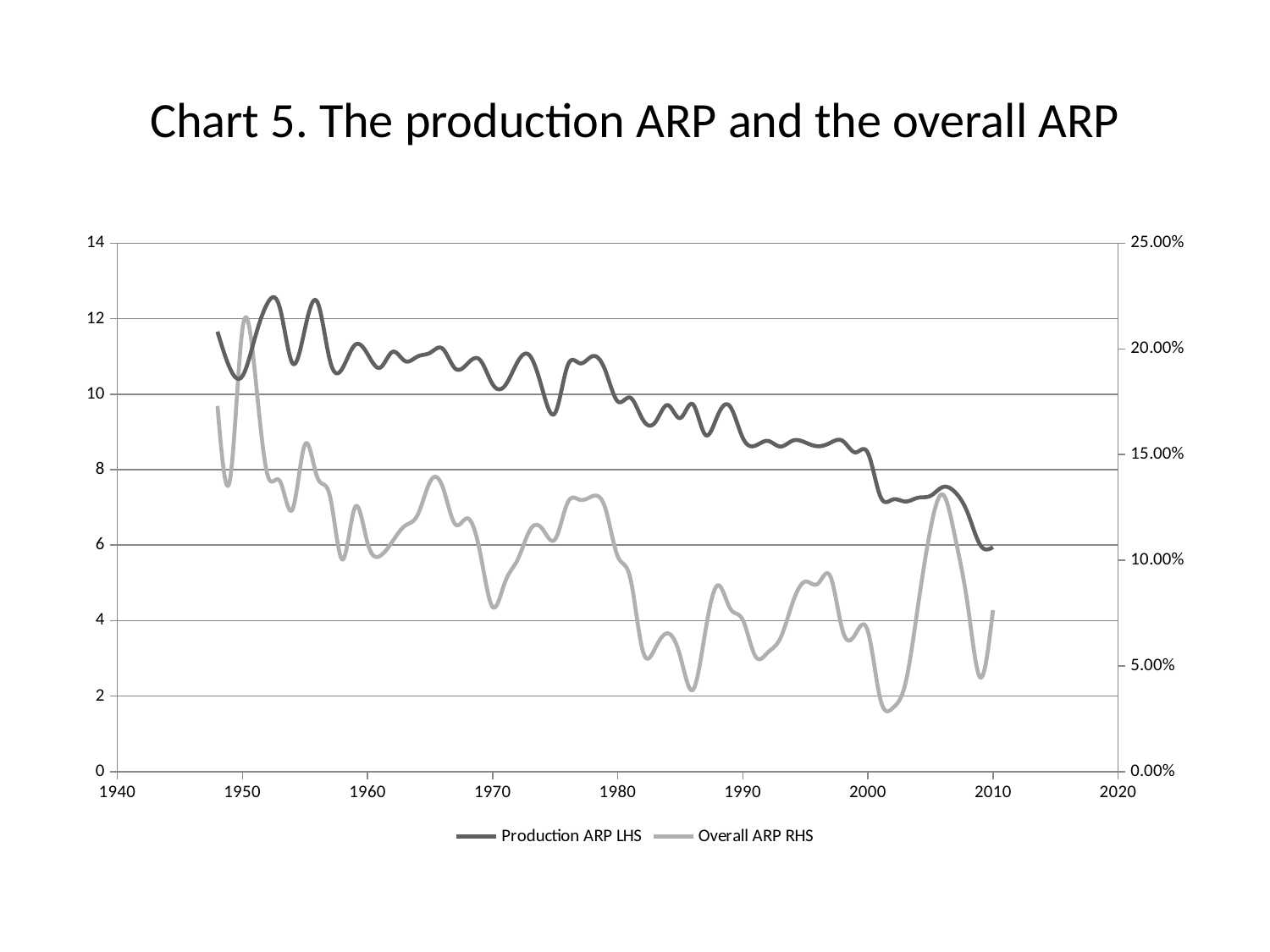
What is the title of the chart? Chart 5. The production ARP and the overall ARP How many series does the legend list? 2 Is the value for Overall ARP RHS around 2001 greater or less than 5.00%? less Which series is plotted against the right-hand axis? Overall ARP RHS Is the peak value for Production ARP LHS around 1952 greater or less than 12? greater What kind of chart is shown on the slide? line chart Does the Overall ARP RHS series generally rise or fall from 1950 to 2010? fall Is the value for Production ARP LHS in 2000 greater or less than 10? less Does the Production ARP LHS series generally rise or fall from 1950 to 2010? fall